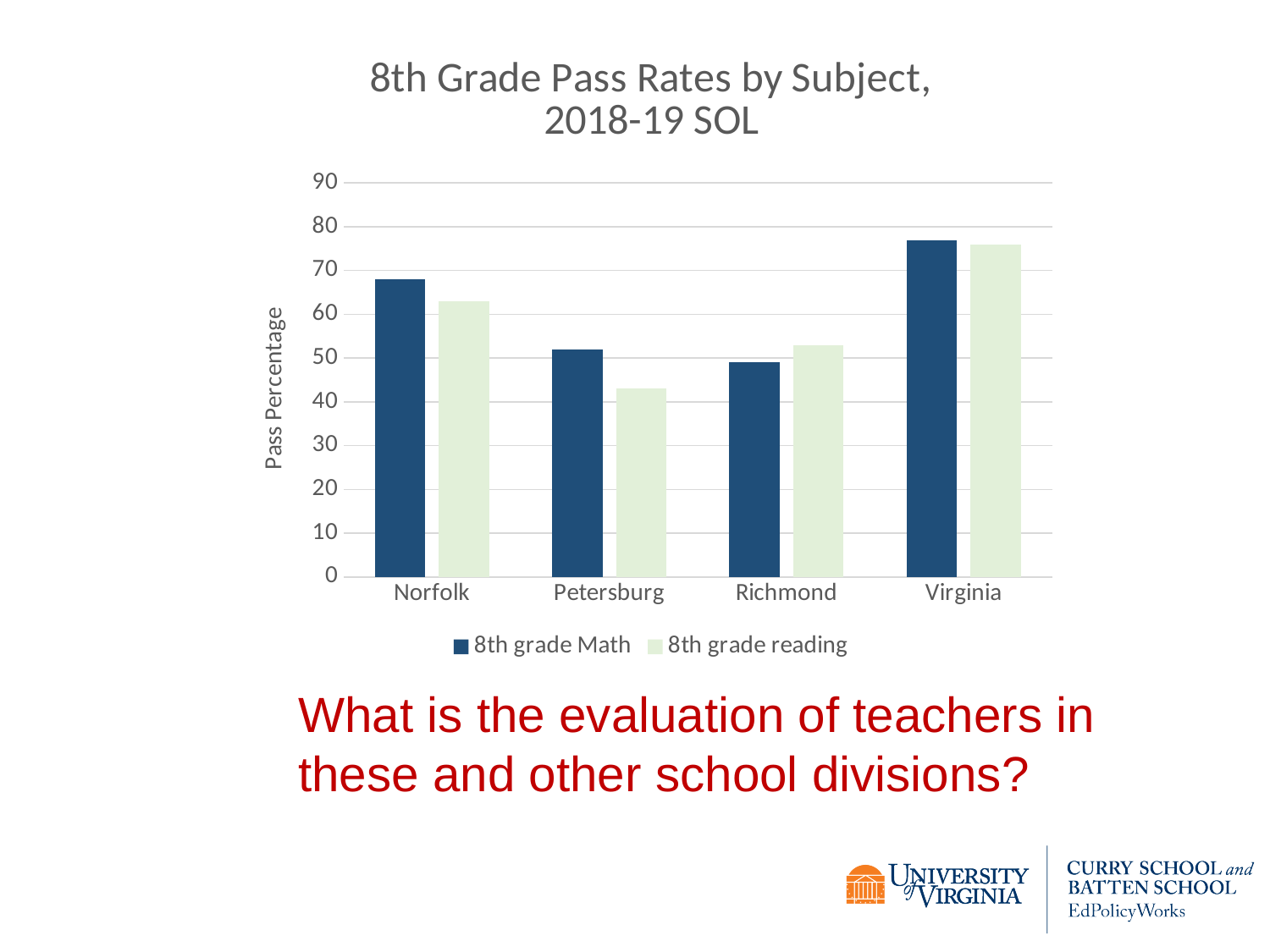
Is the 8th grade Math pass rate for Norfolk greater or less than 60? greater Which category has the highest 8th grade Math pass rate? Virginia What kind of chart is shown on the slide? bar chart For Petersburg, which is larger: the 8th grade Math pass rate or the 8th grade reading pass rate? 8th grade Math Which category has the highest 8th grade reading pass rate? Virginia What is the title of the chart? 8th Grade Pass Rates by Subject, 2018-19 SOL For Norfolk, which is larger: the 8th grade Math pass rate or the 8th grade reading pass rate? 8th grade Math Is the 8th grade Math pass rate for Virginia greater or less than 70? greater Which category has the lowest 8th grade reading pass rate? Petersburg How many series does the legend list? 2 Is the 8th grade reading pass rate for Petersburg greater or less than 50? less How many categories are shown on the x axis? 4